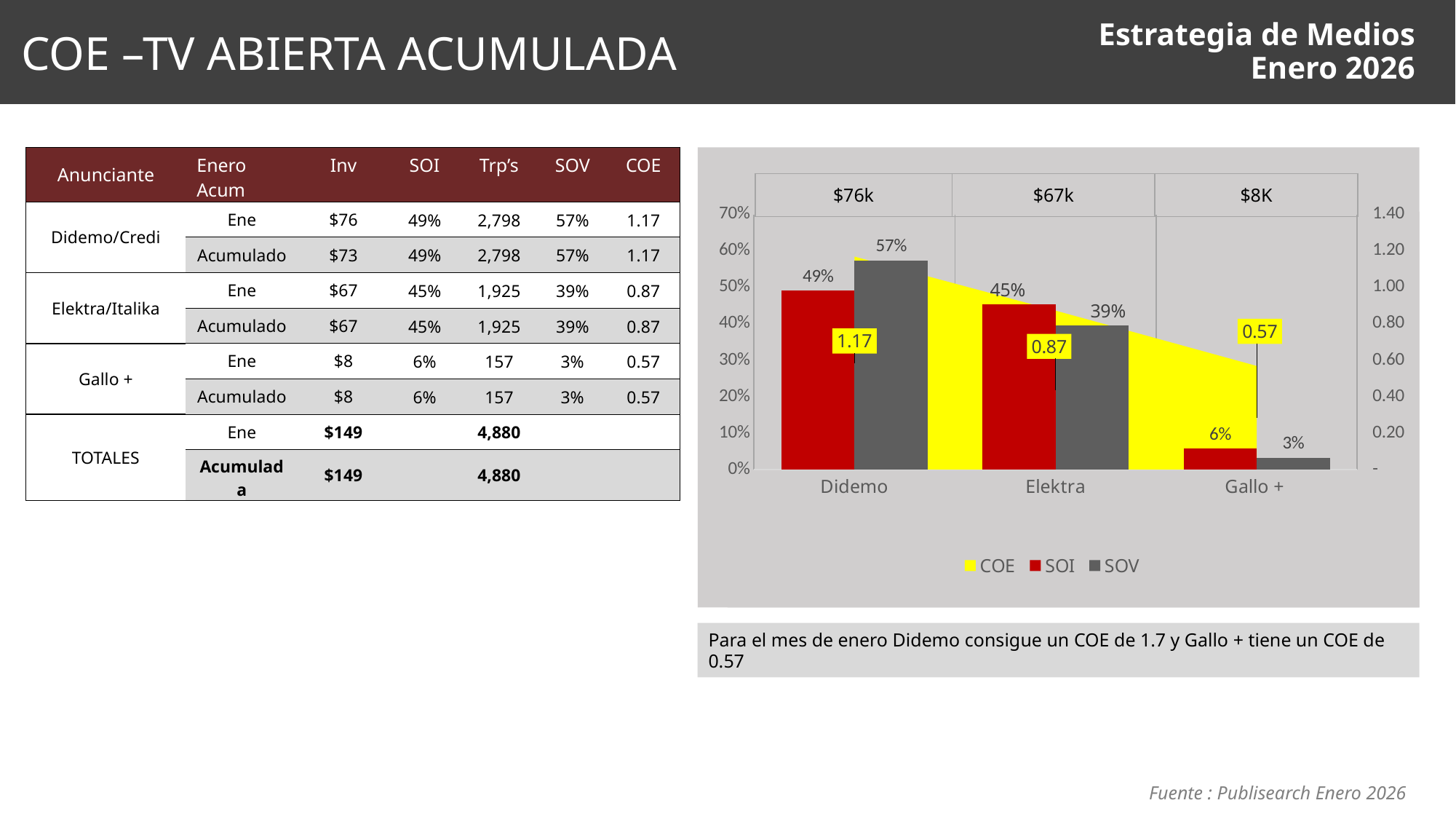
Which is larger in the chart: the SOI value for Elektra or the SOV value for Elektra? SOI (45%) Do the COE values rise or fall from Didemo to Gallo + in the chart? fall What is the difference between the SOV values for Didemo and Elektra in the chart? 18% Which colour represents the SOI series in the chart? Red Which category has the highest SOV value in the chart? Didemo Which category has the lowest SOI value in the chart? Gallo + How many categories are shown on the x axis of the chart? 3 What is the difference between the COE values for Didemo and Elektra in the chart? 0.30 How many series does the chart legend list? 3 What is the SOV value for Elektra in the chart? 39% What COE value is shown for Gallo + in the chart? 0.57 What is the SOI value for Didemo in the chart? 49%